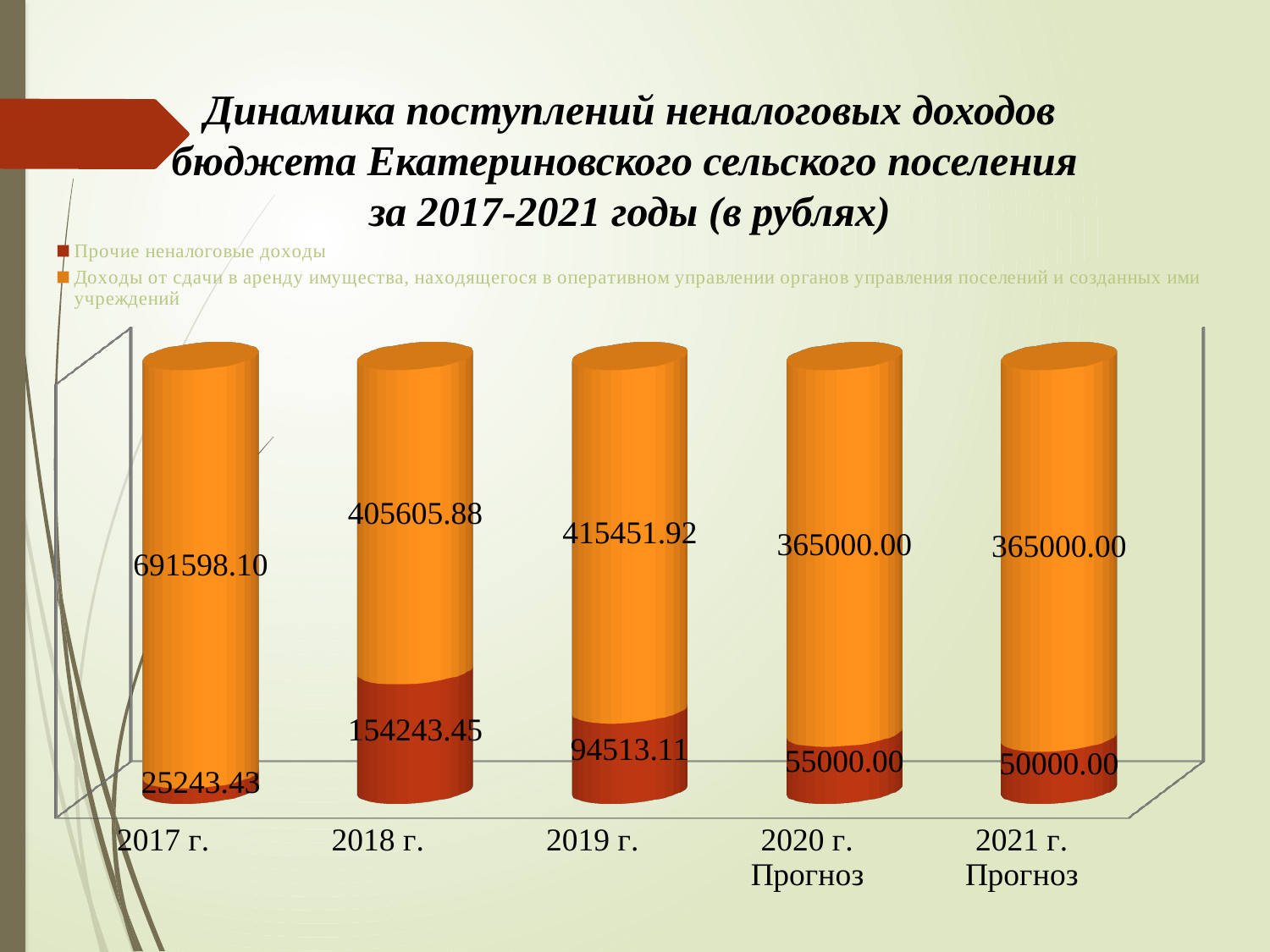
In which year is 'Доходы от сдачи в аренду имущества' the highest? 2017 г. What is the value of 'Прочие неналоговые доходы' for 2021 г. Прогноз? 50000.00 How many years (categories) are shown on the x axis? 5 How many series does the legend list? 2 Do the values of 'Прочие неналоговые доходы' rise or fall from 2019 г. to 2021 г. Прогноз? Fall What is the value of 'Доходы от сдачи в аренду имущества' for 2017 г.? 691598.10 What kind of chart is shown on the slide? Stacked bar chart What is the difference between 'Прочие неналоговые доходы' in 2018 г. and 2019 г.? 59730.34 In which year is 'Прочие неналоговые доходы' the lowest? 2017 г. What is the total of the two series for 2020 г. Прогноз? 420000.00 Which is larger: 'Доходы от сдачи в аренду имущества' in 2018 г. or in 2019 г.? 2019 г. What is the value of 'Прочие неналоговые доходы' for 2018 г.? 154243.45